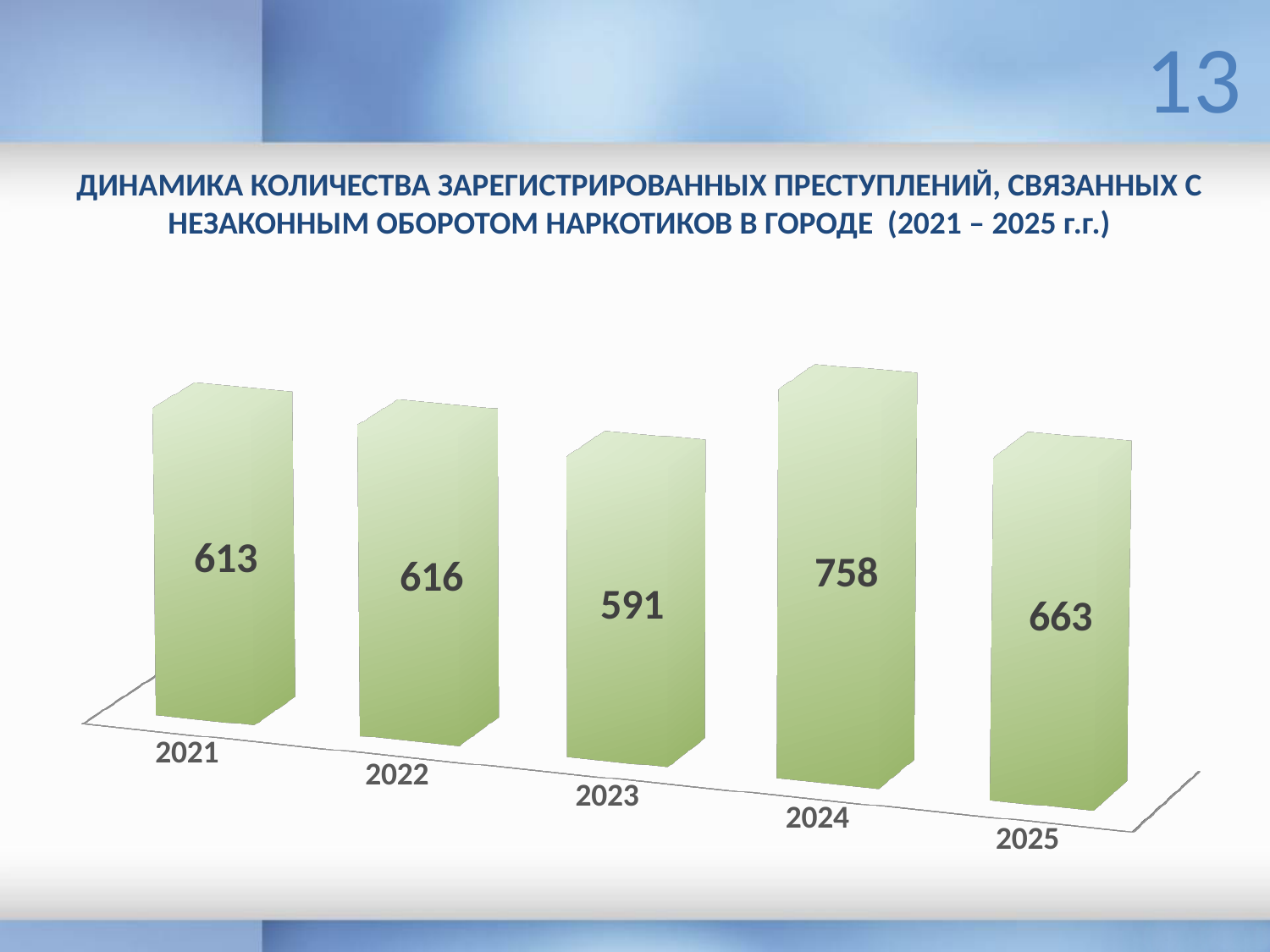
Which year has the highest value? 2024 What is the value for 2025? 663 What is the difference between the values for 2024 and 2023? 167 What is the value for 2023? 591 Does the value rise or fall from 2024 to 2025? fall What is the value for 2021? 613 What is the difference between the values for 2025 and 2021? 50 How many years are shown on the chart? 5 Which is larger, the value for 2022 or the value for 2025? 2025 Which year has the lowest value? 2023 What colour are the bars on the chart? green What kind of chart is shown on the slide? bar chart